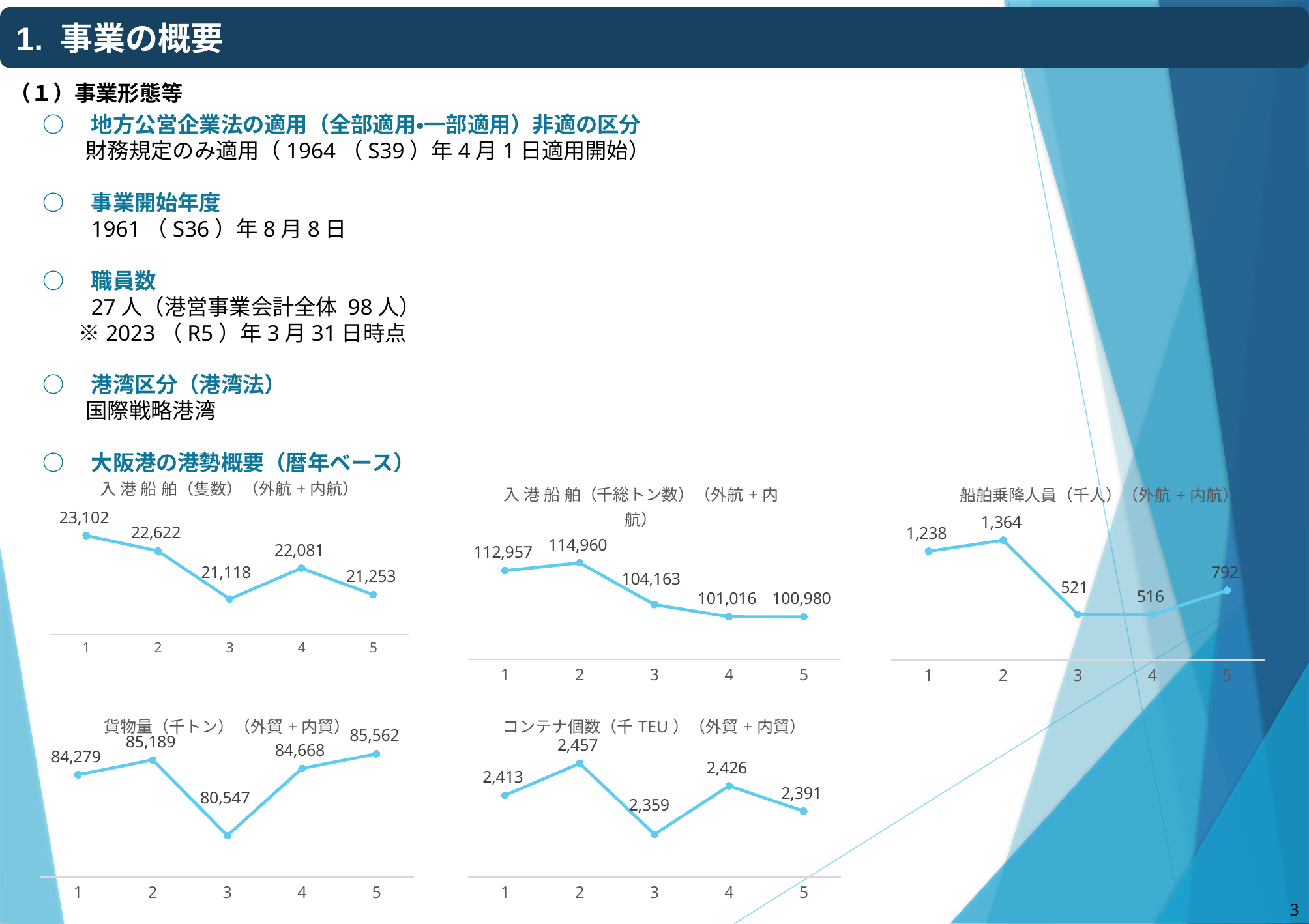
In the 貨物量（千トン）（外貿＋内貿） chart, what is the value at point 3? 80,547 What type of chart is the 貨物量（千トン）（外貿＋内貿） chart? line chart In the 貨物量（千トン）（外貿＋内貿） chart, which is larger, the value at point 1 or the value at point 5? point 5 In the 入港船舶（隻数）（外航＋内航） chart, what is the value at point 1? 23,102 How many data points does the 入港船舶（千総トン数）（外航＋内航） chart have? 5 In the 船舶乗降人員（千人）（外航＋内航） chart, which point has the highest value? 2 In the 入港船舶（千総トン数）（外航＋内航） chart, what is the difference between the values at point 1 and point 3? 8,794 In the コンテナ個数（千TEU）（外貿＋内貿） chart, what is the difference between the values at point 4 and point 5? 35 In the 船舶乗降人員（千人）（外航＋内航） chart, what is the value at point 5? 792 In the 入港船舶（千総トン数）（外航＋内航） chart, what is the value at point 2? 114,960 In the 入港船舶（隻数）（外航＋内航） chart, which point has the lowest value? 3 In the コンテナ個数（千TEU）（外貿＋内貿） chart, what is the value at point 2? 2,457